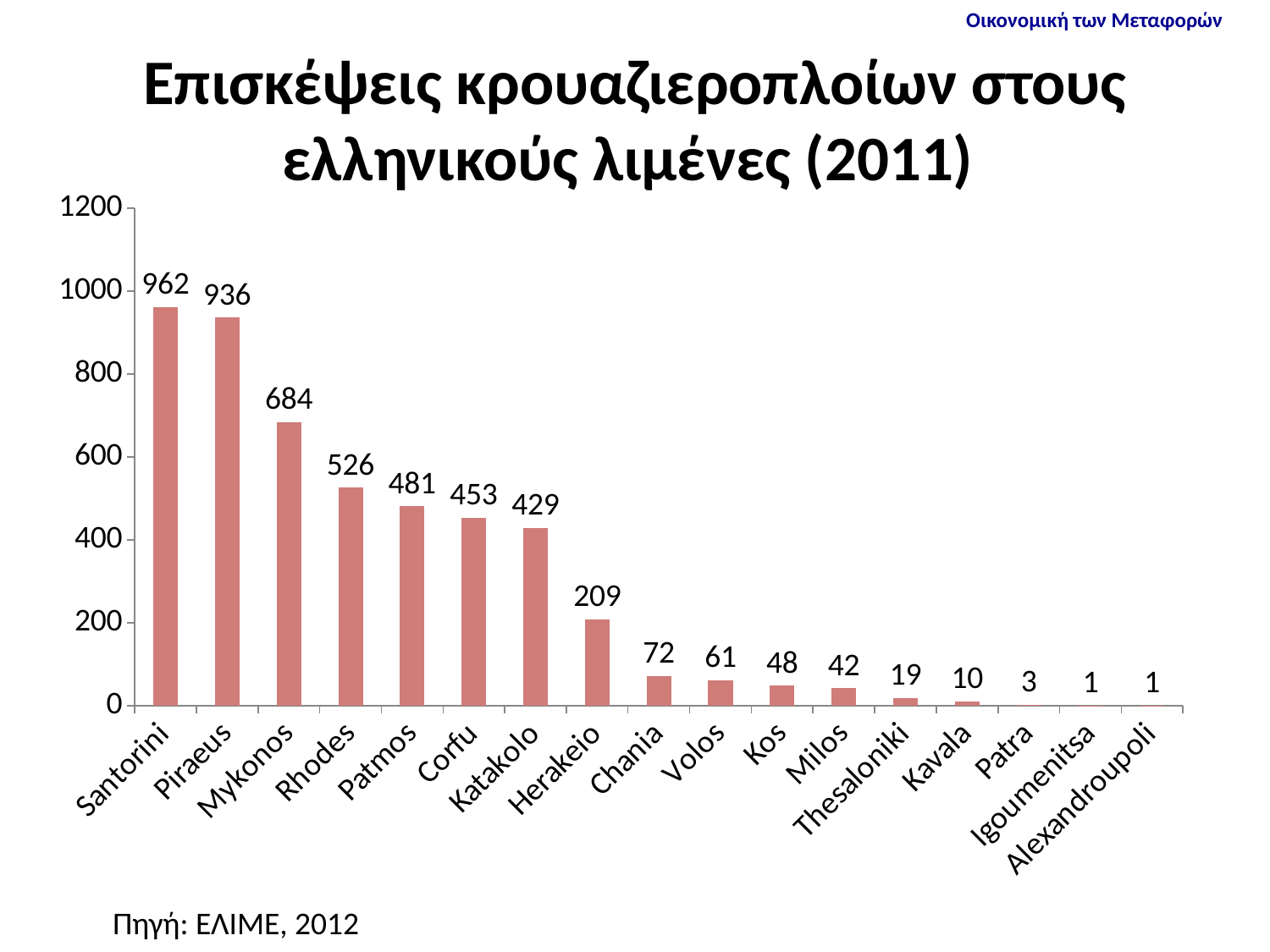
Is the value for Mykonos greater or less than 600? greater How many ports are shown on the x axis? 17 Which is larger, the value for Patmos or the value for Katakolo? Patmos What is the value for Kavala? 10 What is the source cited below the chart? ΕΛΙΜΕ, 2012 What is the value for Santorini? 962 What is the difference between the values for Santorini and Piraeus? 26 What is the difference between the values for Mykonos and Rhodes? 158 Which port has the highest value? Santorini Do the values rise or fall from left to right along the x axis? fall What kind of chart is shown on the slide? bar chart What is the value for Herakleio? 209